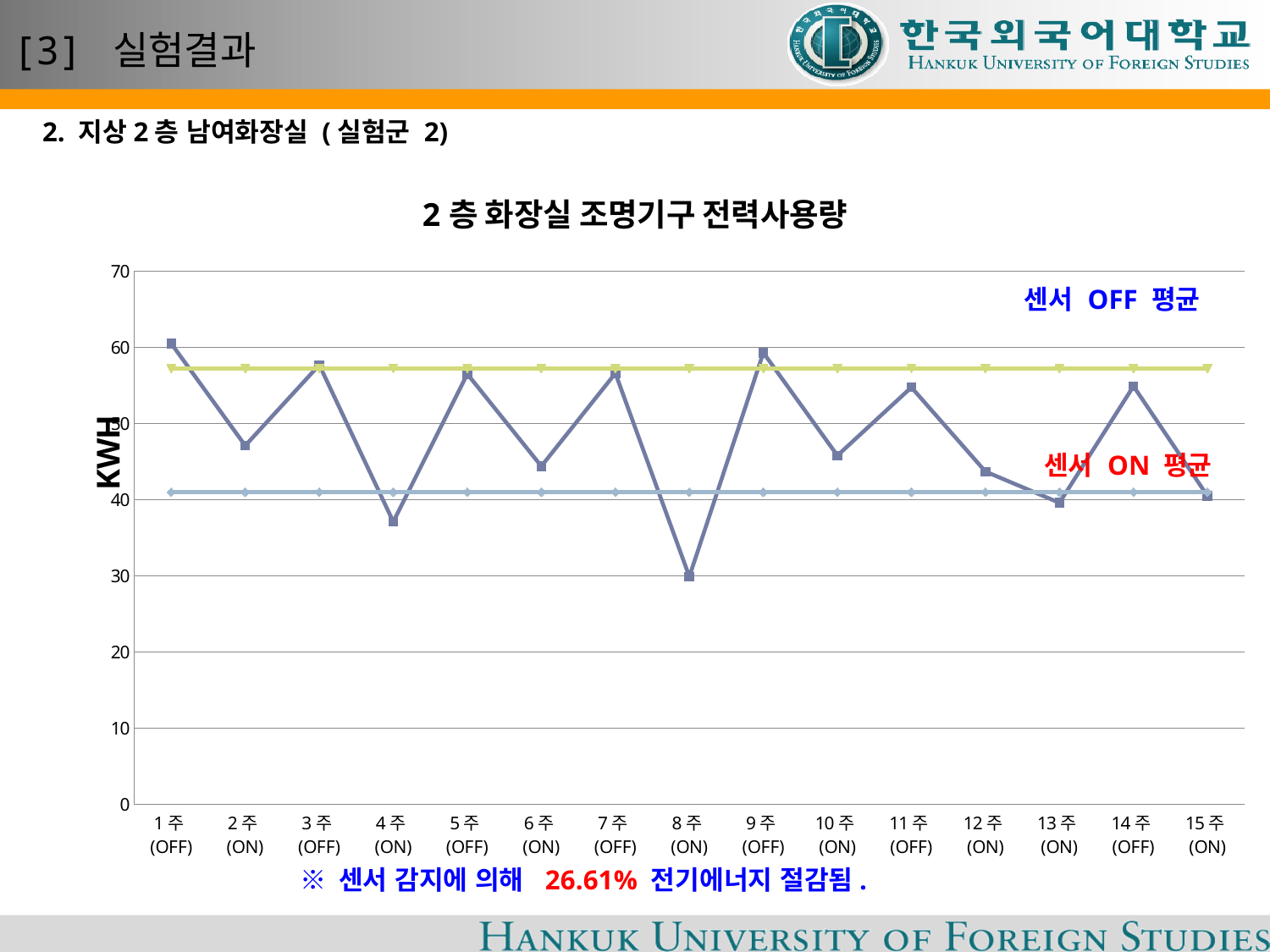
Is the value for 8 주 (ON) greater or less than 40? less Which is larger, the value for 3 주 (OFF) or the value for 4 주 (ON)? 3 주 (OFF) Which week has the lowest power usage? 8 주 (ON) Which is larger, the value for 8 주 (ON) or the value for 9 주 (OFF)? 9 주 (OFF) What is the label on the y axis of the chart? KWH Is the value for 6 주 (ON) greater or less than 50? less Is the value for 11 주 (OFF) greater or less than 50? greater How many weekly data points are plotted along the x axis? 15 What kind of chart is shown on the slide? line chart Which horizontal average line is higher, 센서 OFF 평균 or 센서 ON 평균? 센서 OFF 평균